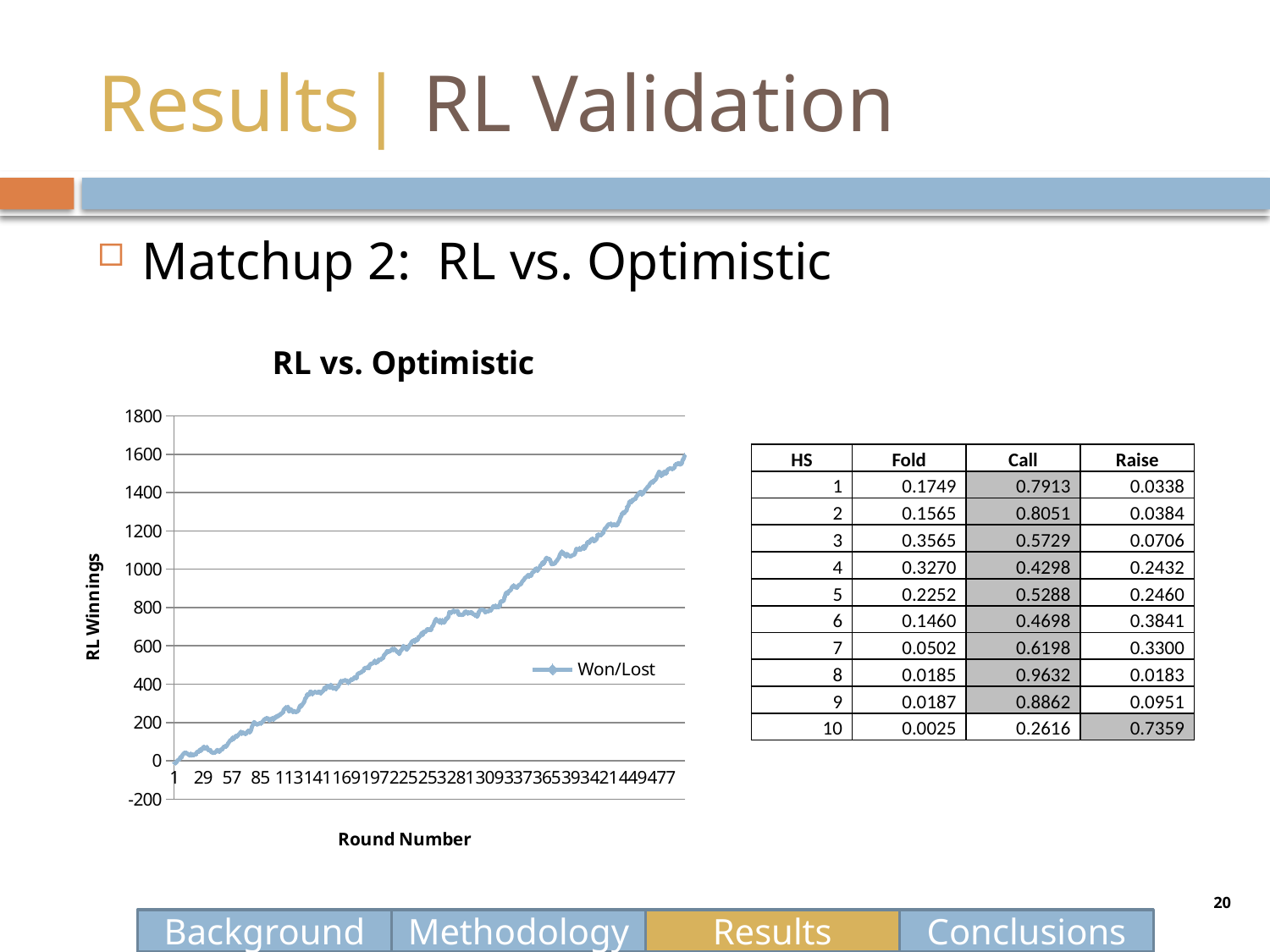
Do the RL Winnings values rise or fall as the round number increases? rise What is the name of the series shown in the chart legend? Won/Lost Which is larger, the Won/Lost value at round 477 or at round 29? round 477 What is the title of the chart? RL vs. Optimistic Is the value of Won/Lost at round 141 greater or less than 600? less Is the value of Won/Lost at round 1 greater or less than 200? less Is the value of Won/Lost at round 421 greater or less than 1000? greater What kind of chart is shown on the slide? line chart How many series does the chart legend list? 1